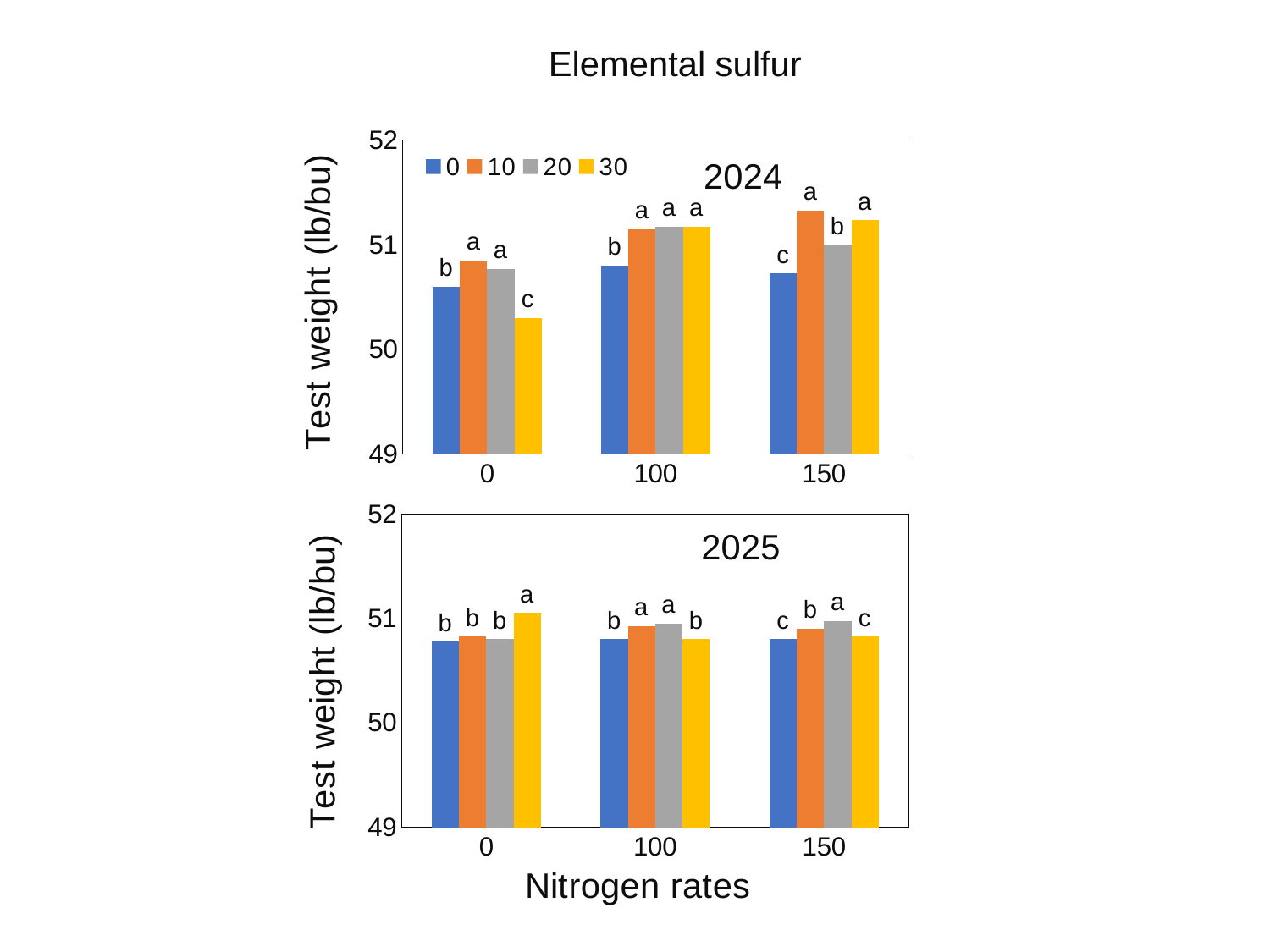
In the 2025 chart, is the value for series 0 at nitrogen rate 0 greater or less than 51? less What kind of chart is the 2024 chart at the top of the slide? bar chart In the 2024 chart at nitrogen rate 150, which is larger: the bar for series 10 or the bar for series 20? 10 In the 2024 chart, do the values for series 30 rise or fall as the nitrogen rate increases from 0 to 150? rise In the 2024 chart, is the value for series 30 at nitrogen rate 0 greater or less than 51? less In the 2024 chart at nitrogen rate 0, which is larger: the bar for series 10 or the bar for series 30? 10 In the 2024 chart, which bar is the lowest overall? 30 at nitrogen rate 0 How many series does the legend list on the 2024 chart? 4 What is the y-axis label on the 2025 chart? Test weight (lb/bu) How many nitrogen rate categories are shown on the x axis of the 2025 chart? 3 What is the title printed above the charts on the slide? Elemental sulfur In the 2024 chart, is the value for series 10 at nitrogen rate 150 greater or less than 51? greater